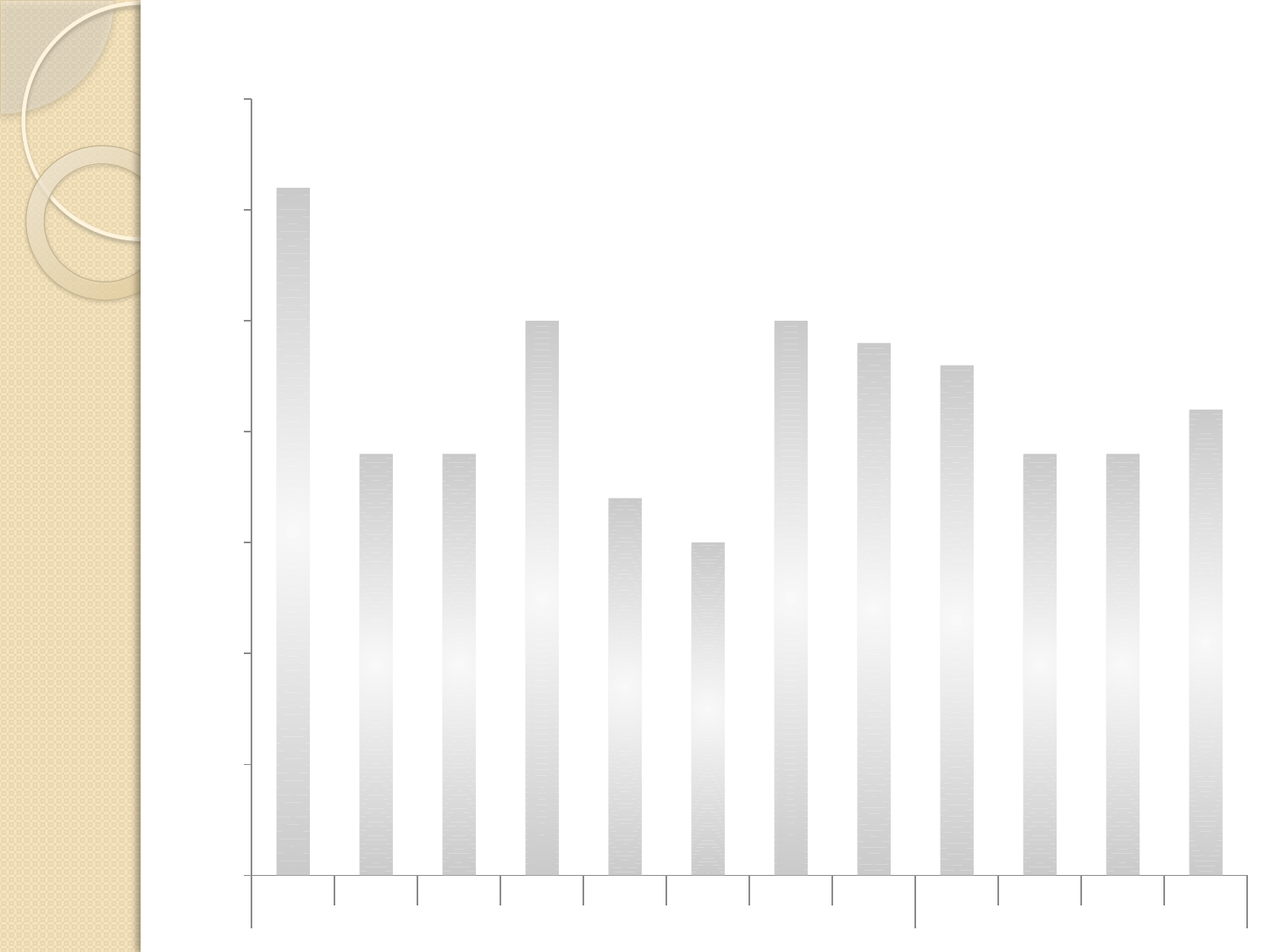
Counting from the left, which bar is the tallest in the chart? the first bar Which is taller, the first bar from the left or the second bar from the left? the first bar Which is taller, the sixth bar from the left or the seventh bar from the left? the seventh bar How many bars does the chart contain? 12 Counting from the left, which bar is the shortest in the chart? the sixth bar Does the chart display a title? No Does the chart display a legend? No What kind of chart is shown on the slide? bar chart Which is taller, the fourth bar from the left or the fifth bar from the left? the fourth bar